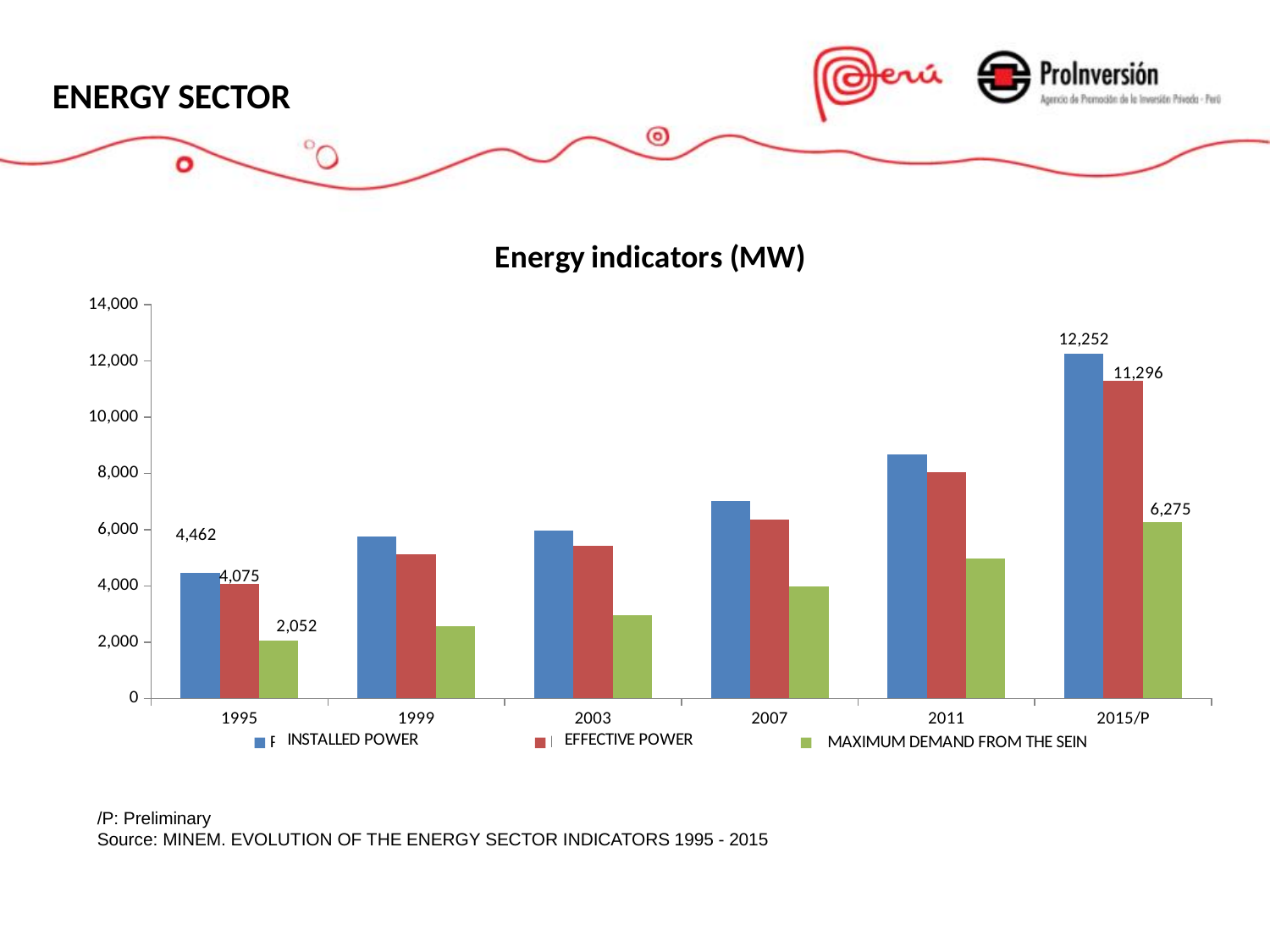
How many series does the legend list? 3 What is the value of INSTALLED POWER for 2015/P? 12,252 Is the value of INSTALLED POWER for 2011 greater or less than 8,000? greater What is the difference between INSTALLED POWER in 2015/P and INSTALLED POWER in 1995? 7,790 What is the value of MAXIMUM DEMAND FROM THE SEIN for 2015/P? 6,275 What is the difference between INSTALLED POWER and EFFECTIVE POWER in 2015/P? 956 In which year is MAXIMUM DEMAND FROM THE SEIN lowest? 1995 In which year is INSTALLED POWER highest? 2015/P What is the value of MAXIMUM DEMAND FROM THE SEIN for 1995? 2,052 Does INSTALLED POWER rise or fall from 1995 to 2015/P? rise What is the value of EFFECTIVE POWER for 1995? 4,075